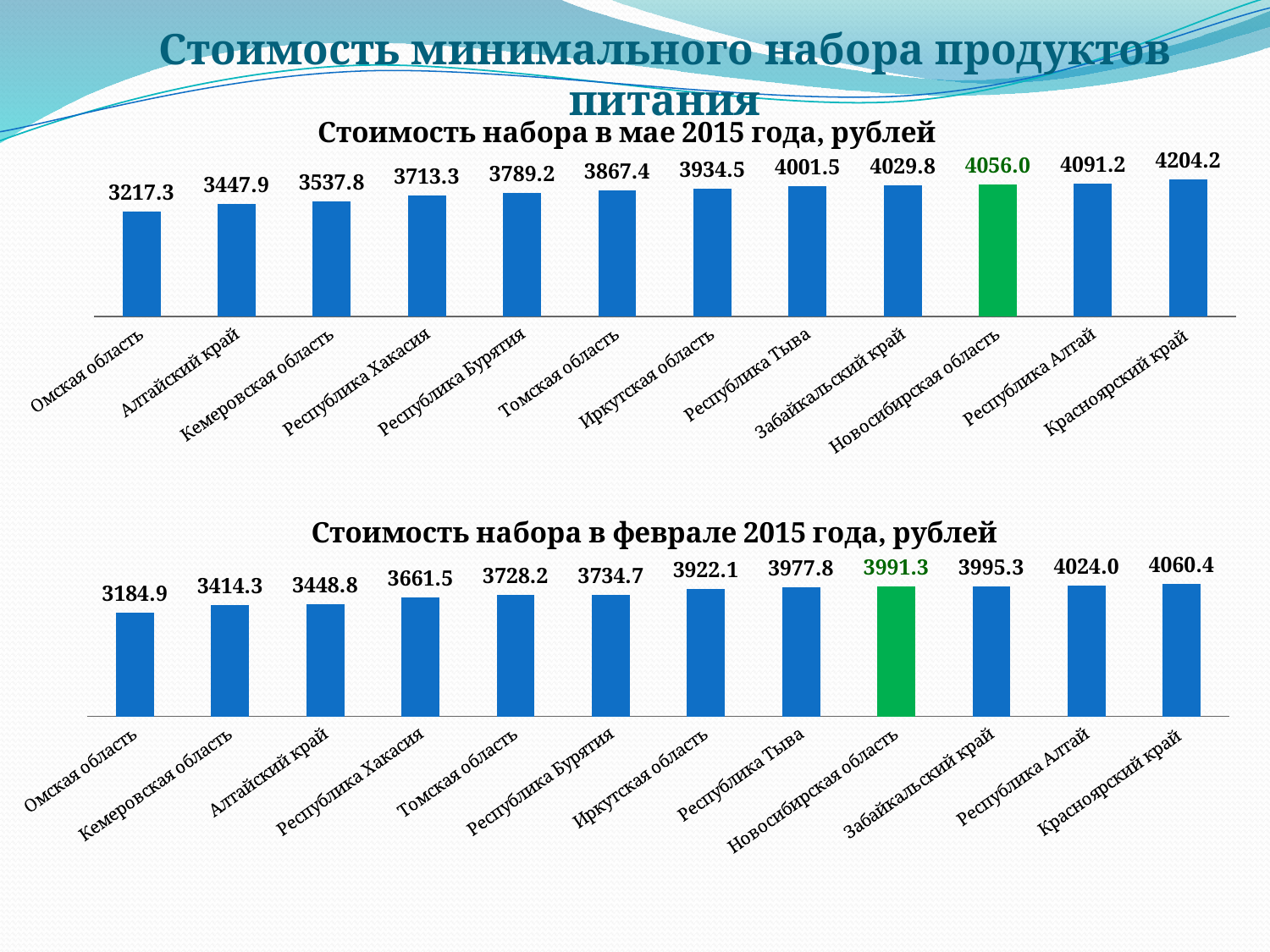
In the chart 'Стоимость набора в феврале 2015 года, рублей', which region has the lowest value? Омская область In the chart 'Стоимость набора в феврале 2015 года, рублей', what is the value for Республика Тыва? 3977.8 In the chart 'Стоимость набора в феврале 2015 года, рублей', what is the difference between Республика Алтай and Новосибирская область? 32.7 In the chart 'Стоимость набора в мае 2015 года, рублей', do the values rise or fall from left to right? Rise In the chart 'Стоимость набора в феврале 2015 года, рублей', which region's bar is coloured green? Новосибирская область How many regions are shown in the chart 'Стоимость набора в мае 2015 года, рублей'? 12 In the chart 'Стоимость набора в феврале 2015 года, рублей', which is larger: Кемеровская область or Алтайский край? Алтайский край In the chart 'Стоимость набора в мае 2015 года, рублей', which is larger: Томская область or Республика Бурятия? Томская область What type of chart is 'Стоимость набора в феврале 2015 года, рублей'? Bar chart In the chart 'Стоимость набора в мае 2015 года, рублей', what is the value for Новосибирская область? 4056.0 In the chart 'Стоимость набора в мае 2015 года, рублей', what is the difference between Красноярский край and Омская область? 986.9 In the chart 'Стоимость набора в мае 2015 года, рублей', which region has the highest value? Красноярский край